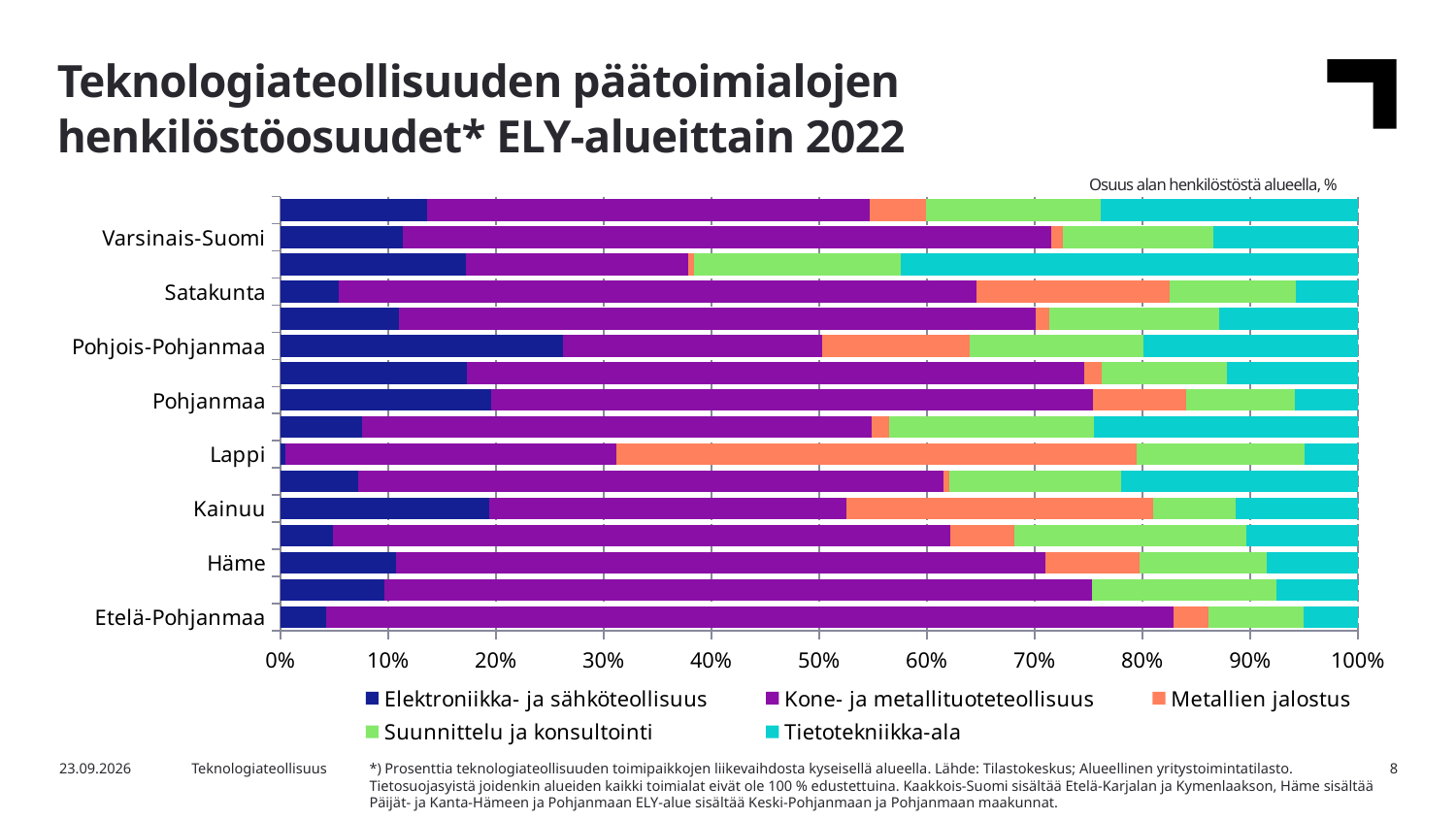
Is the Metallien jalostus share for Lappi greater or less than 40%? greater Which has the larger Metallien jalostus share, Lappi or Varsinais-Suomi? Lappi How many series does the legend list? 5 What is the title of the chart on the slide? Teknologiateollisuuden päätoimialojen henkilöstöosuudet* ELY-alueittain 2022 Which has the larger Elektroniikka- ja sähköteollisuus share, Pohjois-Pohjanmaa or Häme? Pohjois-Pohjanmaa Is the Elektroniikka- ja sähköteollisuus share for Pohjois-Pohjanmaa greater or less than 20%? greater Is the Elektroniikka- ja sähköteollisuus share for Satakunta greater or less than 10%? less Which series is shown in orange in the legend? Metallien jalostus Among the labelled regions, which has the largest Metallien jalostus share? Lappi What kind of chart is shown on the slide? Stacked bar chart